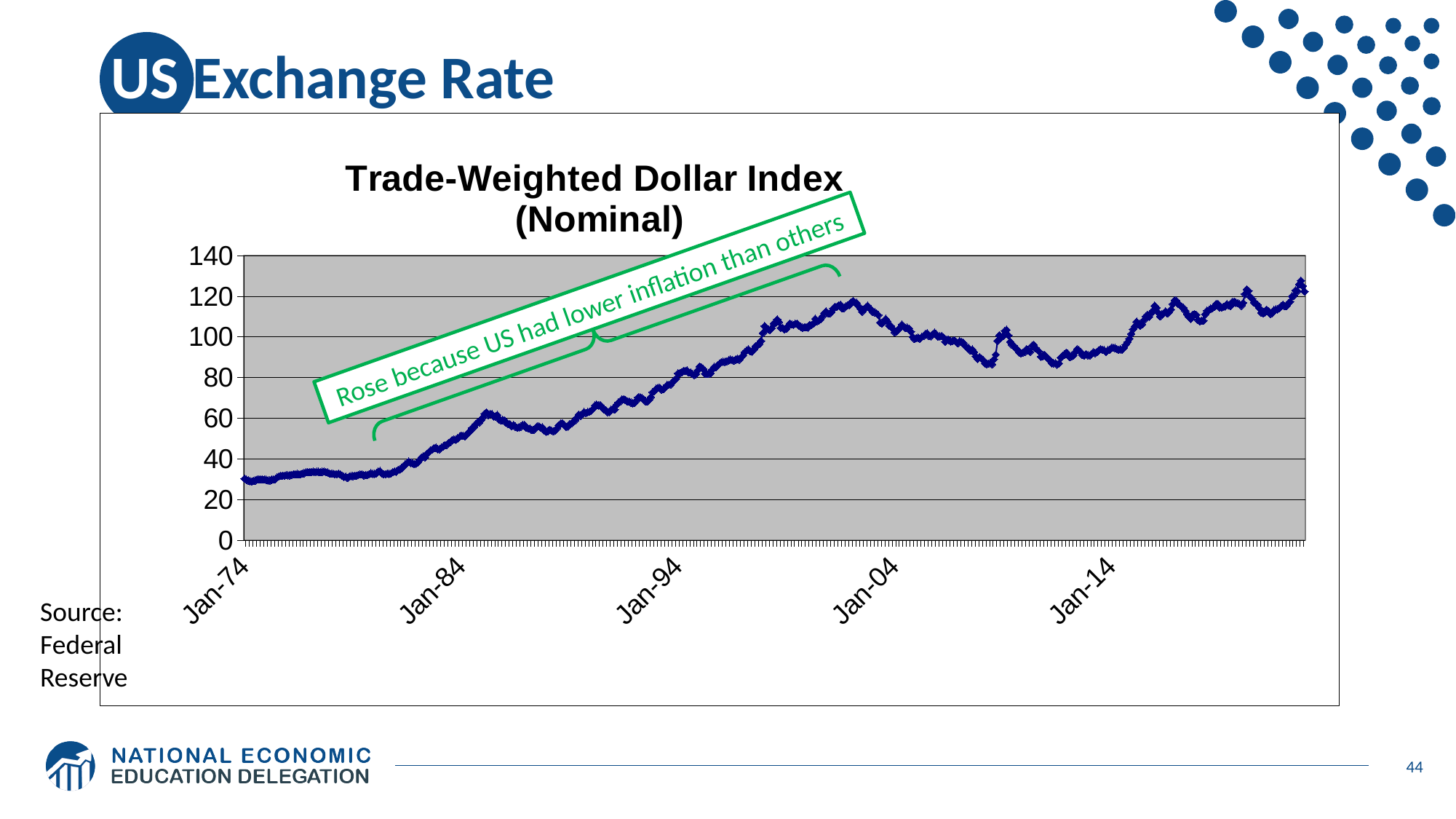
Is the value of the index at Jan-84 greater or less than 40? greater Is the value of the index at Jan-14 greater or less than 100? less Is the highest value reached by the index greater or less than 120? greater What does the green annotation on the chart say? Rose because US had lower inflation than others Overall, does the index rise or fall from Jan-74 to the end of the series? rise Does the index rise or fall between Jan-74 and Jan-84? rise What is the title of the chart? Trade-Weighted Dollar Index (Nominal) What kind of chart is shown on the slide? Line chart How many date labels are shown on the x axis? 5